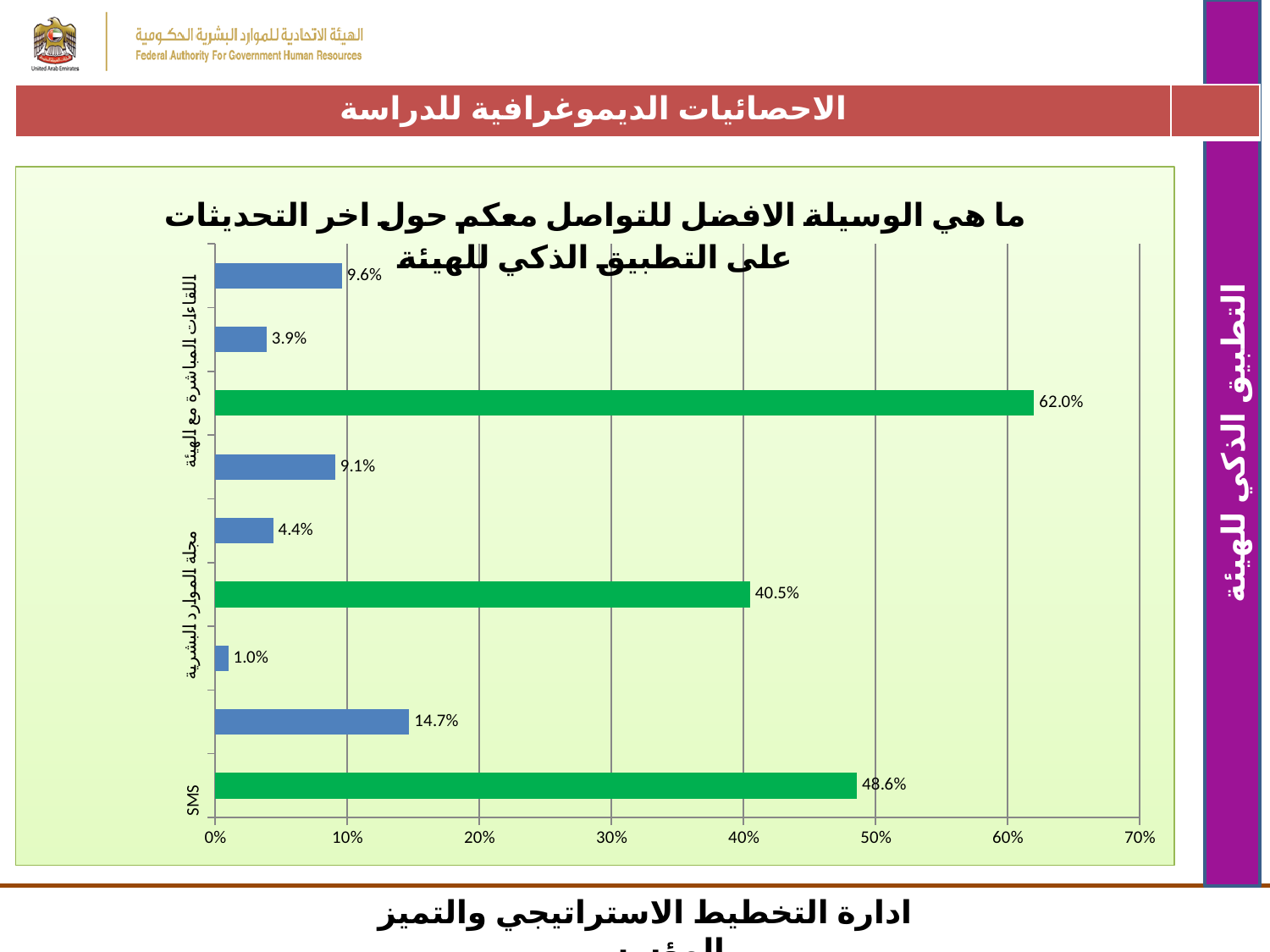
What is the maximum value shown on the horizontal axis? 70% Which is larger: the bar labelled 40.5% or the bar labelled 48.6%? 48.6% What is the value of the bottom bar, labelled SMS? 48.6% How many bars are plotted in the chart? 9 Is the value of the bar labelled 14.7% greater or less than 20%? less What is the highest value shown in the chart? 62.0% How many bars in the chart are coloured green? 3 What kind of chart is shown on the slide? bar chart What is the value of the topmost bar in the chart? 9.6% What is the difference between the largest bar (62.0%) and the bottom bar (48.6%)? 13.4 percentage points Is the value of the longest bar greater or less than 60%? greater What is the lowest value shown in the chart? 1.0%